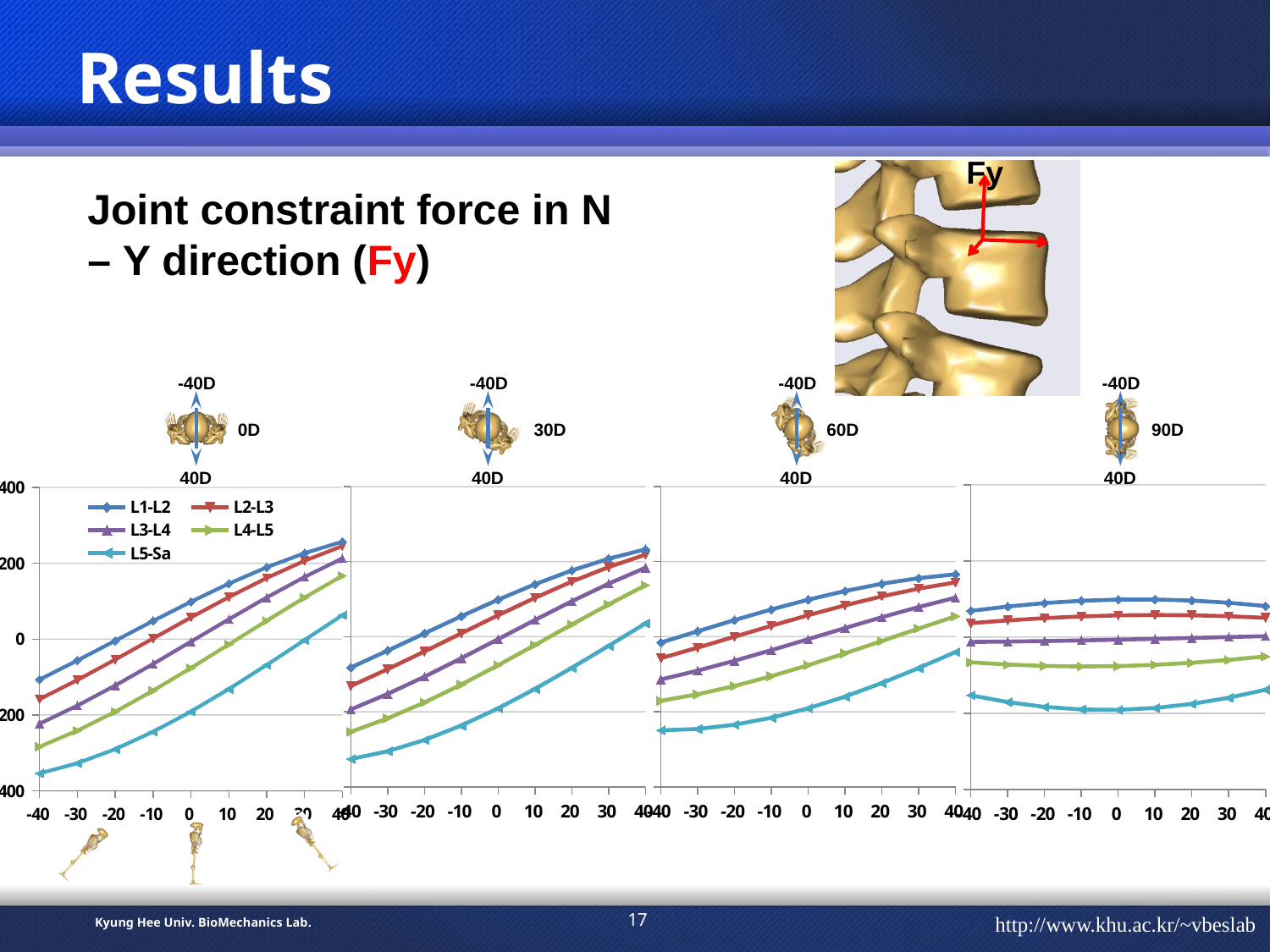
In the 0D chart, which is larger at x = 40: L1-L2 or L5-Sa? L1-L2 How many line charts are shown on the slide? 4 Which series does the legend on the 0D chart list last? L5-Sa In the 0D chart, does the L1-L2 series rise or fall as x increases from -40 to 40? rise In the 90D chart, is the value of L1-L2 at x = 0 greater or less than 200? less In the 0D chart, is the value of L1-L2 at x = 40 greater or less than 200? greater In the 0D chart, which series has the lowest value at x = -40? L5-Sa In the 0D chart, which series has the highest value at x = 0? L1-L2 How many series does the legend on the 0D chart list? 5 What kind of chart is the leftmost (0D) chart? line chart In the 60D chart, which series has the lowest value at x = -40? L5-Sa In the 0D chart, is the value of L5-Sa at x = -40 greater or less than -200? less